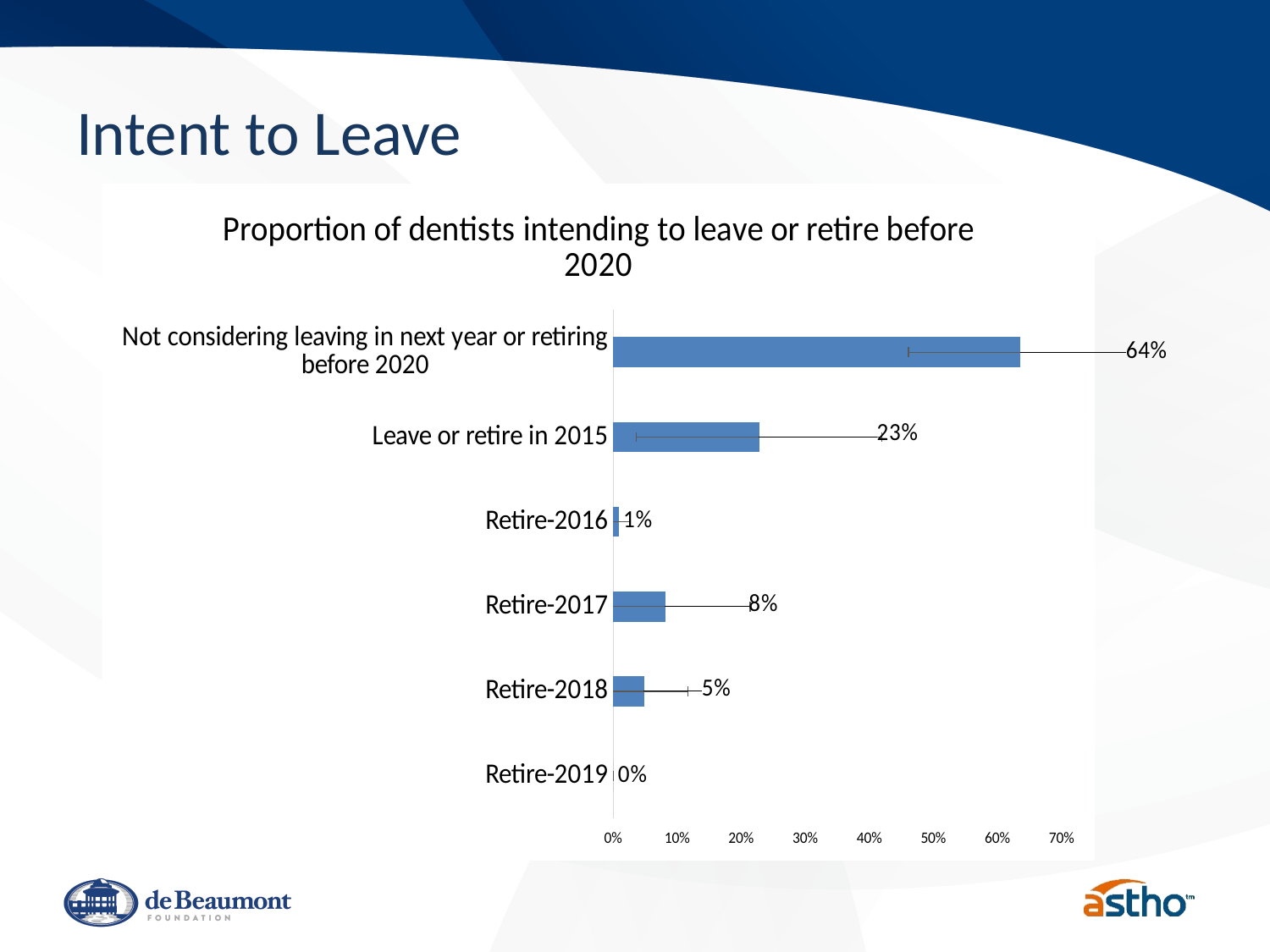
What is the value for 'Retire-2018'? 5% Is the value for 'Not considering leaving in next year or retiring before 2020' greater or less than 50%? greater What is the value for 'Leave or retire in 2015'? 23% How many categories are shown in the chart? 6 What is the value for 'Retire-2017'? 8% Which is larger, the value for 'Retire-2017' or 'Retire-2018'? Retire-2017 What kind of chart is shown on the slide? bar chart What is the difference between the values for 'Leave or retire in 2015' and 'Retire-2017'? 15% What is the title of the chart? Proportion of dentists intending to leave or retire before 2020 Which category has the highest value? Not considering leaving in next year or retiring before 2020 Which category has the lowest value? Retire-2019 What is the value for 'Not considering leaving in next year or retiring before 2020'? 64%